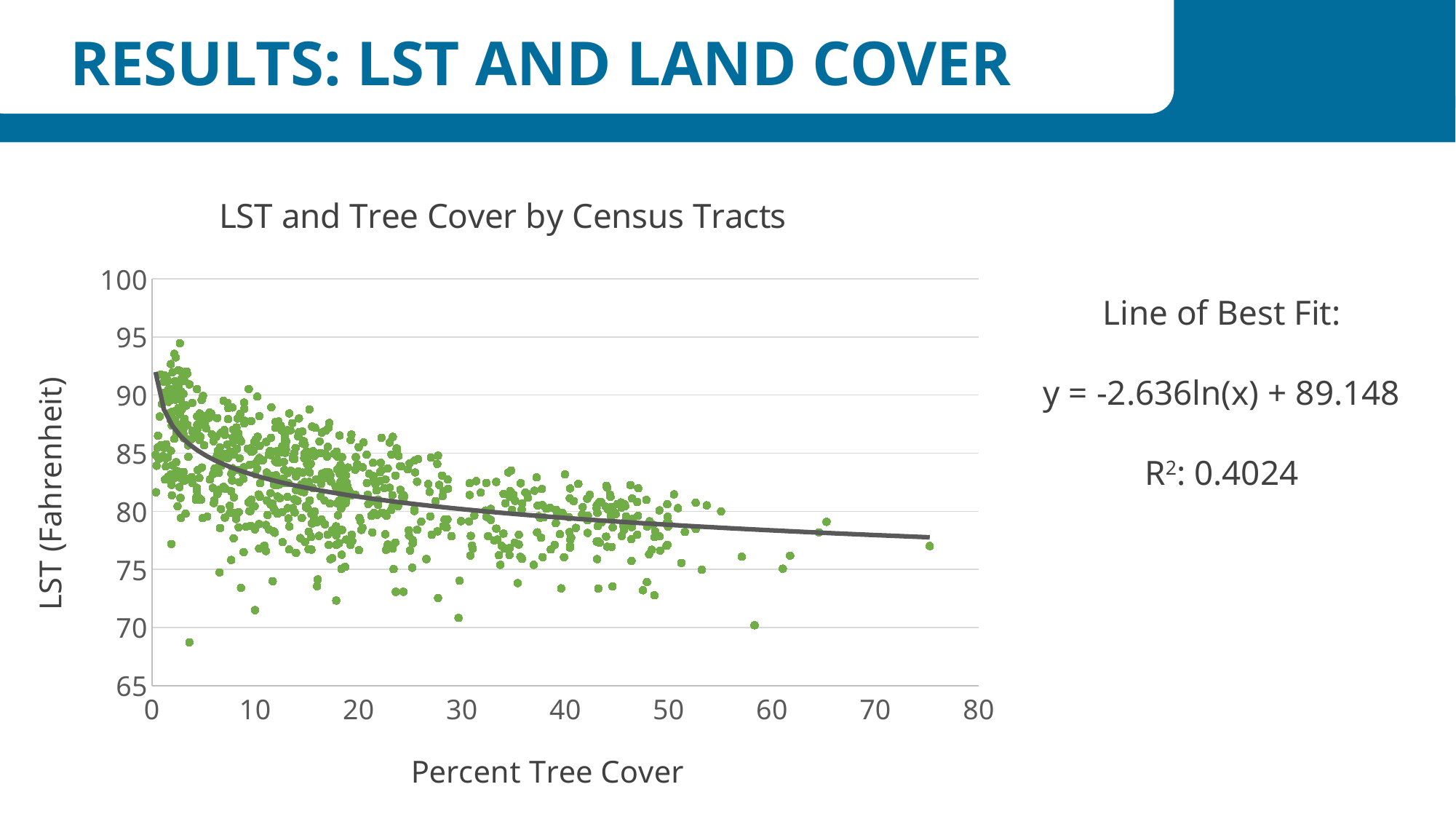
What is the label of the x axis? Percent Tree Cover As Percent Tree Cover increases along the x axis, does LST generally rise or fall? fall Is the fitted line's LST value at 70 percent tree cover greater or less than 80? less What kind of chart is shown on the slide? scatter plot What is the R² value of the line of best fit? 0.4024 What is the highest value shown on the x axis? 80 What is the lowest value shown on the y axis? 65 Is the fitted line's LST value at 10 percent tree cover greater or less than 80? greater What is the title of the chart? LST and Tree Cover by Census Tracts What is the equation of the line of best fit shown on the slide? y = -2.636ln(x) + 89.148 What is the highest value shown on the y axis? 100 Is the fitted line's LST value at 1 percent tree cover greater or less than 85? greater